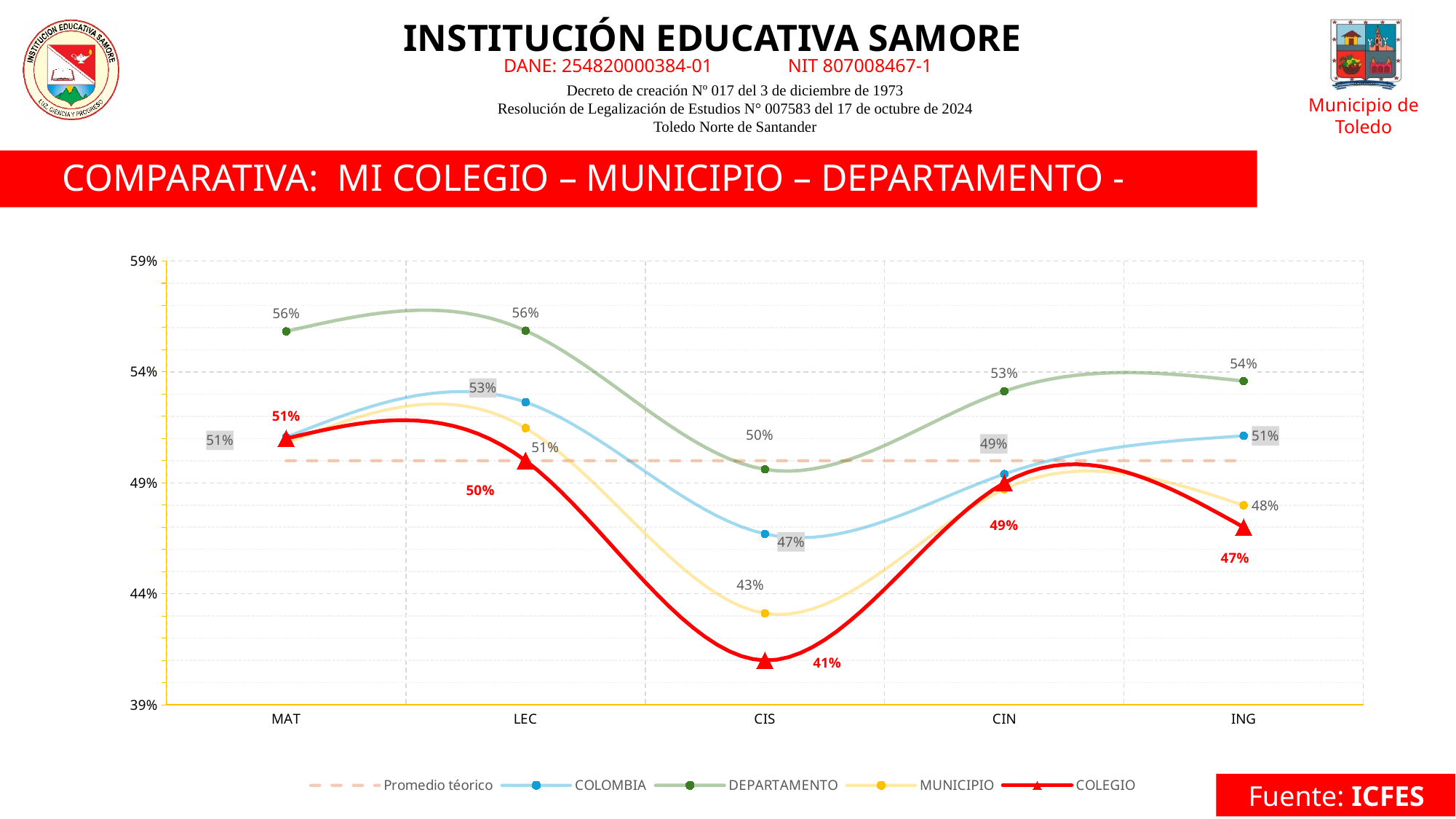
In which category does COLEGIO have its lowest value? CIS What is the value for DEPARTAMENTO in MAT? 56% How many categories are shown on the x axis of the chart? 5 What is the value for COLEGIO in CIS? 41% What is the difference between DEPARTAMENTO and COLEGIO in CIS? 9 percentage points What kind of chart is shown on the slide? line chart How many series does the chart legend list? 5 Which is larger in ING, the value for COLOMBIA or the value for COLEGIO? COLOMBIA What is the value for COLOMBIA in LEC? 53% In which category does COLOMBIA have its highest value? LEC Does the COLEGIO series rise or fall from CIS to CIN? rise What is the value for MUNICIPIO in CIS? 43%